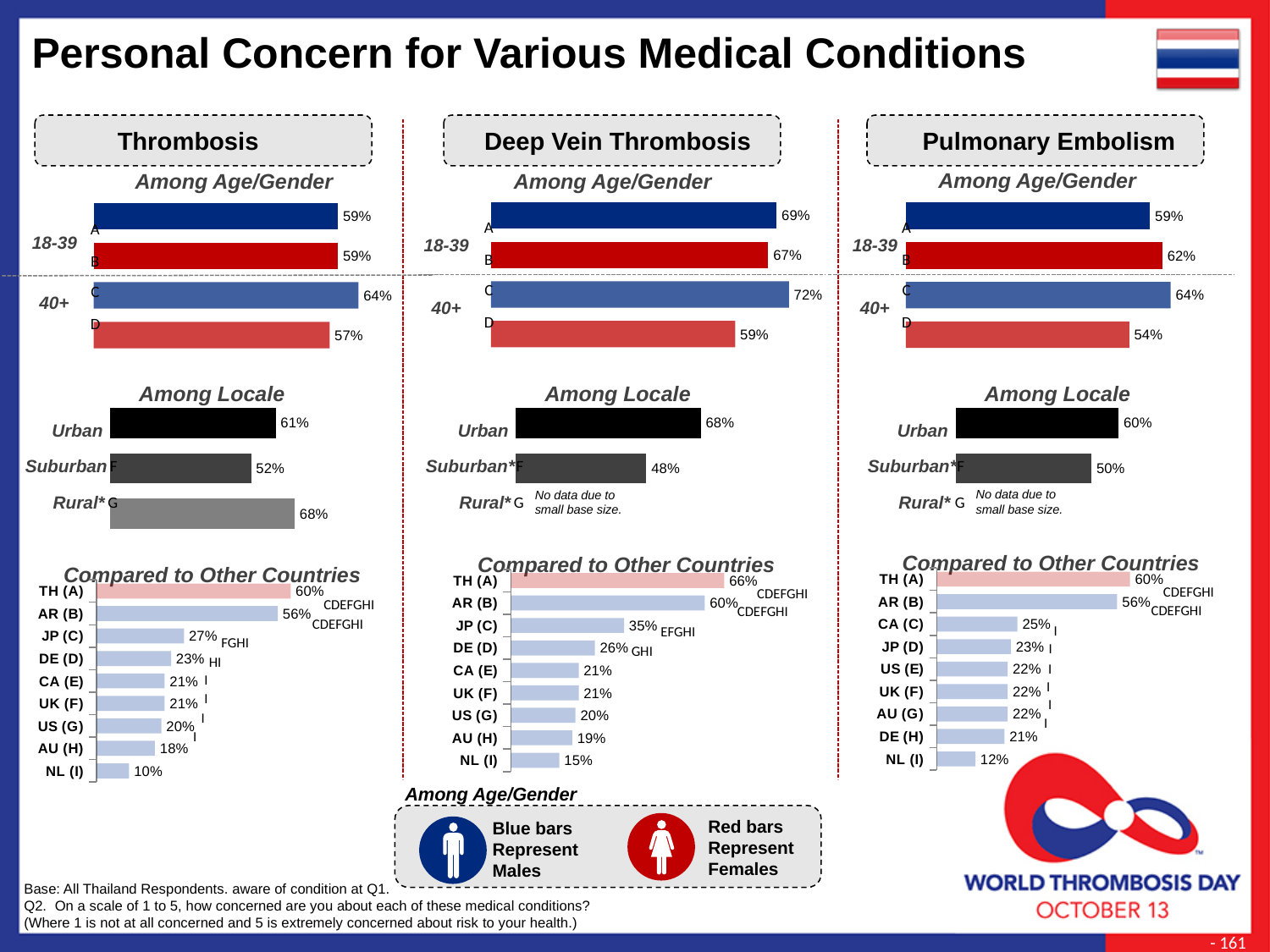
In the Thrombosis 'Among Age/Gender' chart, what is the value for bar C (males 40+)? 64% In the Deep Vein Thrombosis 'Compared to Other Countries' chart, what is the value for JP (C)? 35% In the Thrombosis 'Compared to Other Countries' chart, what is the value for NL (I)? 10% What type of chart is used in the 'Compared to Other Countries' sections? Bar chart In the Deep Vein Thrombosis 'Among Locale' chart, what is the value for Suburban*? 48% In the Pulmonary Embolism 'Among Locale' chart, which is larger, Urban or Suburban*? Urban In the Pulmonary Embolism 'Compared to Other Countries' chart, how many countries are listed? 9 In the Deep Vein Thrombosis 'Among Age/Gender' chart, which bar has the highest value? C According to the legend at the bottom of the slide, what do the red bars in the 'Among Age/Gender' charts represent? Females In the Pulmonary Embolism 'Compared to Other Countries' chart, what is the difference between TH (A) and AR (B)? 4% In the Thrombosis 'Among Locale' chart, which locale has the highest value? Rural* In the Pulmonary Embolism 'Among Age/Gender' chart, what is the difference between bar C and bar D? 10%